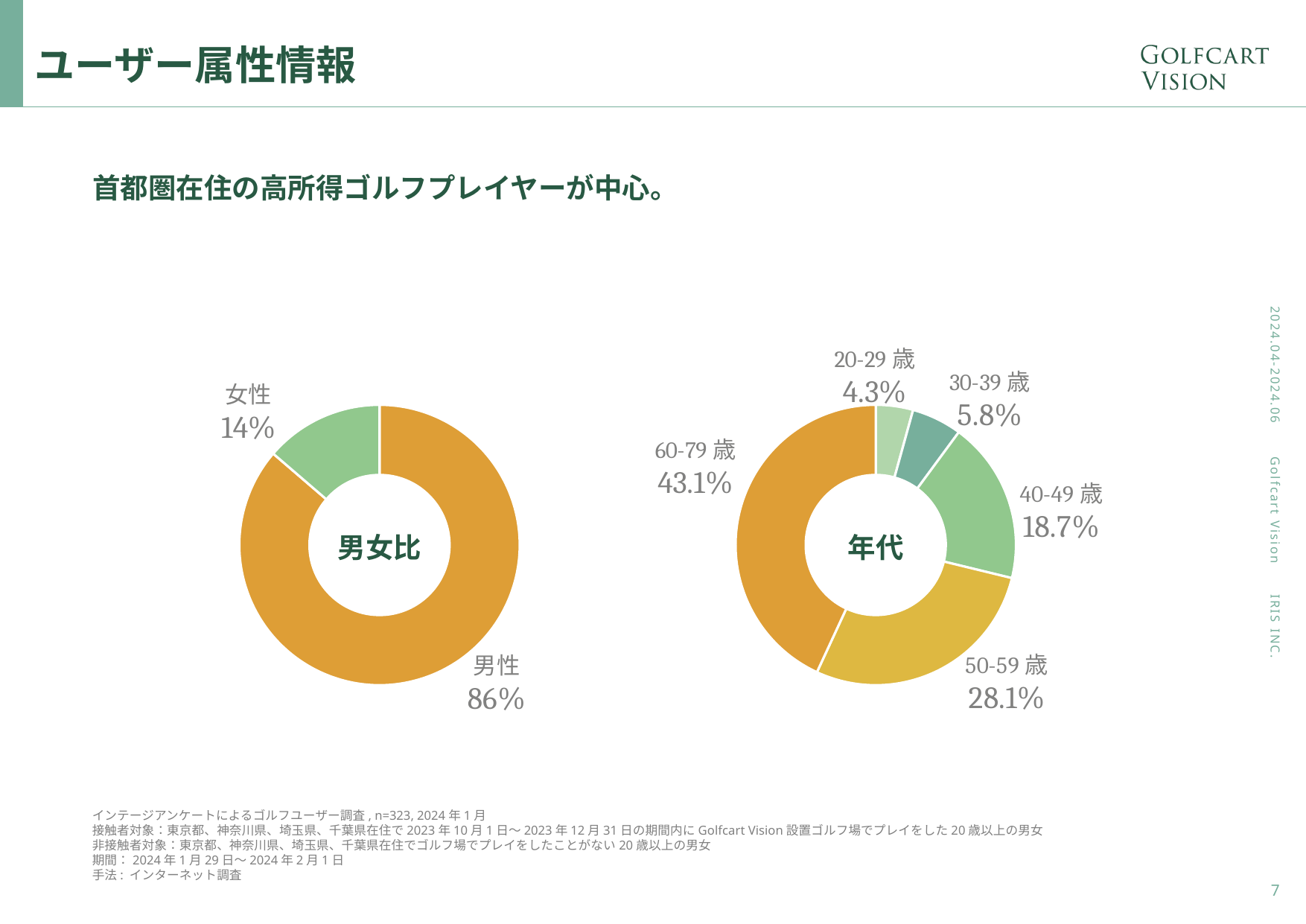
In the 年代 chart, what share is 20-29 歳? 4.3% In the 年代 chart, which age group has the largest share? 60-79 歳 What kind of chart is the 男女比 chart? Doughnut (pie) chart In the 男女比 chart, what share is 女性? 14% In the 年代 chart, what share is 50-59 歳? 28.1% In the 年代 chart, which age group has the smallest share? 20-29 歳 In the 年代 chart, how many age groups are shown? 5 In the 年代 chart, what is the difference between the 60-79 歳 and 50-59 歳 shares? 15.0% In the 男女比 chart, what share is 男性? 86% In the 男女比 chart, what is the difference between the 男性 and 女性 shares? 72% In the 年代 chart, which is larger, 40-49 歳 or 30-39 歳? 40-49 歳 In the 年代 chart, what share is 60-79 歳? 43.1%